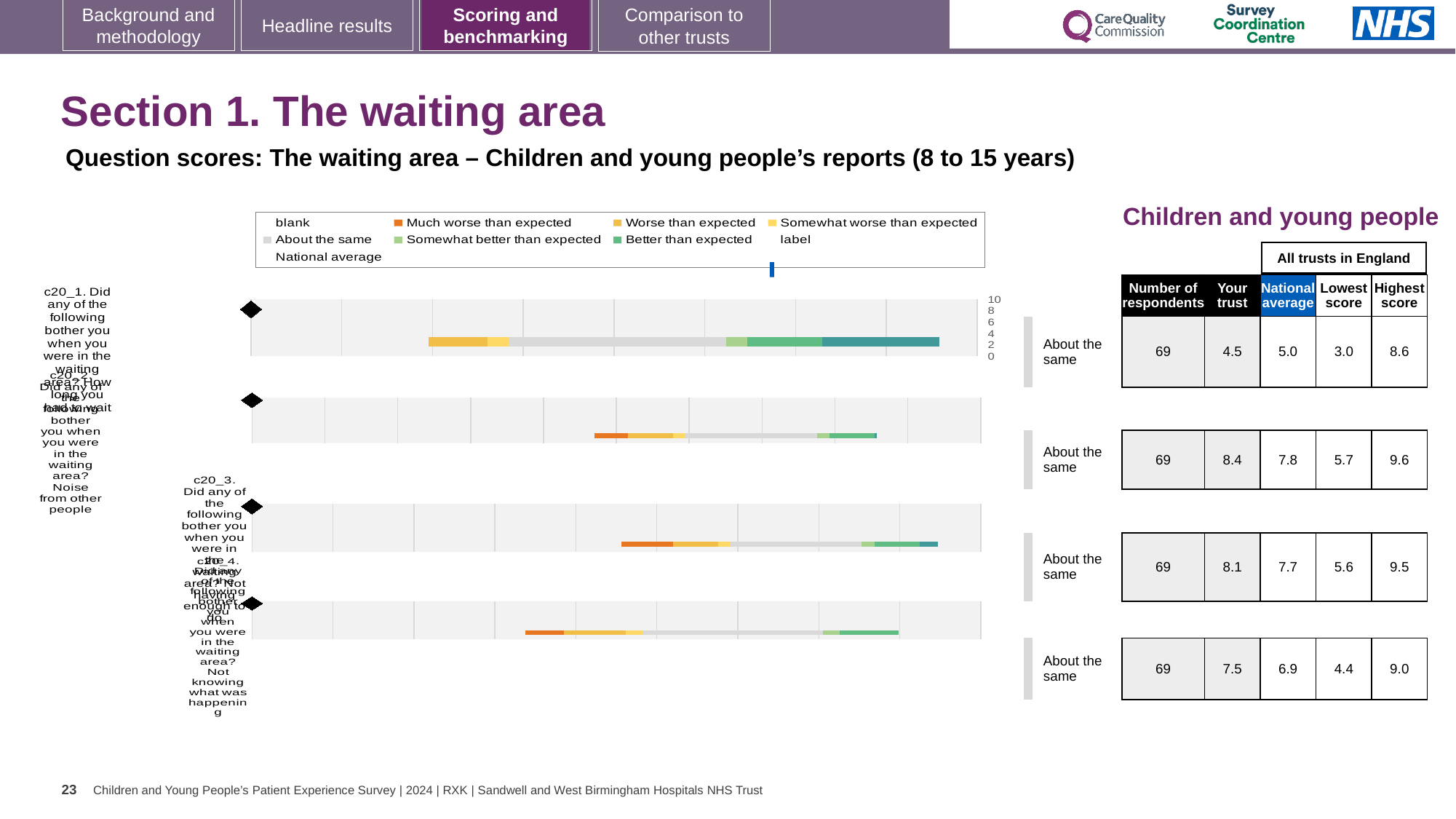
What is the difference between the national average and the 'Your trust' score for c20_1 (Noise from other people)? 0.5 Which question has the lowest 'Your trust' score in the table next to the charts? c20_1 (Noise from other people) How many separate question charts are shown on the slide? 4 For c20_3 (Not having enough to do), which is larger: the 'Your trust' score or the national average? Your trust Which legend entry is shown with a light grey colour? About the same In the table next to the charts, what is the highest score in England for c20_4 (Not knowing what was happening)? 9.0 In the table next to the charts, what is the national average for c20_1 (Noise from other people)? 5.0 Which legend entry is shown with a dark orange colour? Much worse than expected Which question has the highest 'Your trust' score in the table next to the charts? c20_2 (How long you had to wait) What kind of chart is used for each of the four question rows on the slide? Bar chart How many respondents are listed for each of the four waiting area questions? 69 In the table next to the charts, what is the 'Your trust' score for c20_2 (How long you had to wait)? 8.4